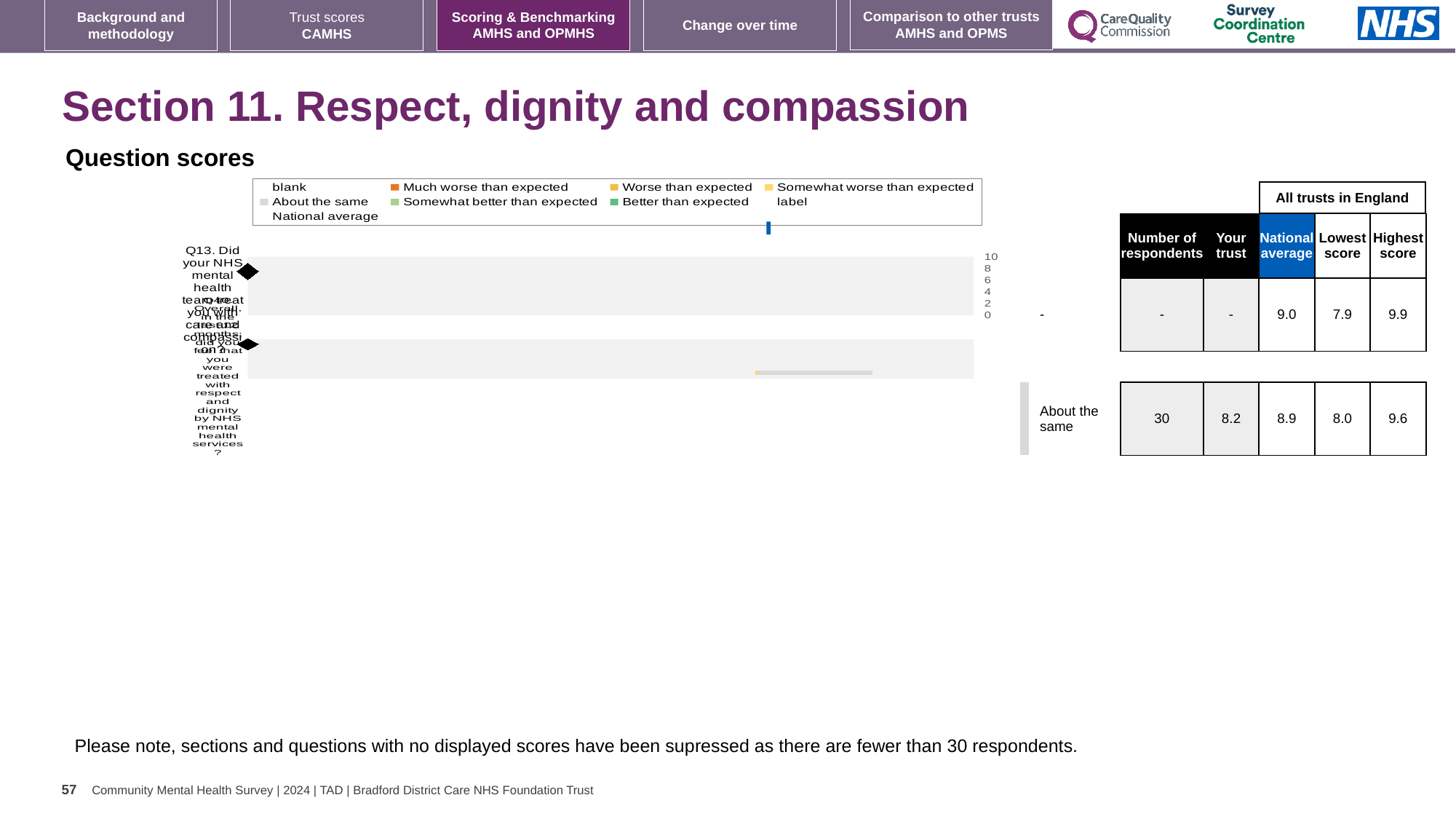
In the table next to the chart, what is the national average for Q14? 8.9 In the table next to the chart, what is the 'Your trust' score for Q14? 8.2 What kind of chart is shown under 'Question scores'? bar chart What benchmark category label is shown for Q14 beside the chart? About the same In the table next to the chart, which is larger for Q14: the 'Your trust' score or the national average? national average In the table next to the chart, what is the difference between the highest and lowest scores for Q13? 2.0 In the table next to the chart, what is the number of respondents for Q14? 30 How many questions (categories) are plotted on the Question scores chart? 2 What is the highest value shown on the chart's numeric axis? 10 In the table next to the chart, what is the difference between the national average and the 'Your trust' score for Q14? 0.7 In the table next to the chart, what is the highest score across all trusts in England for Q13? 9.9 In the table next to the chart, what is the lowest score across all trusts in England for Q14? 8.0